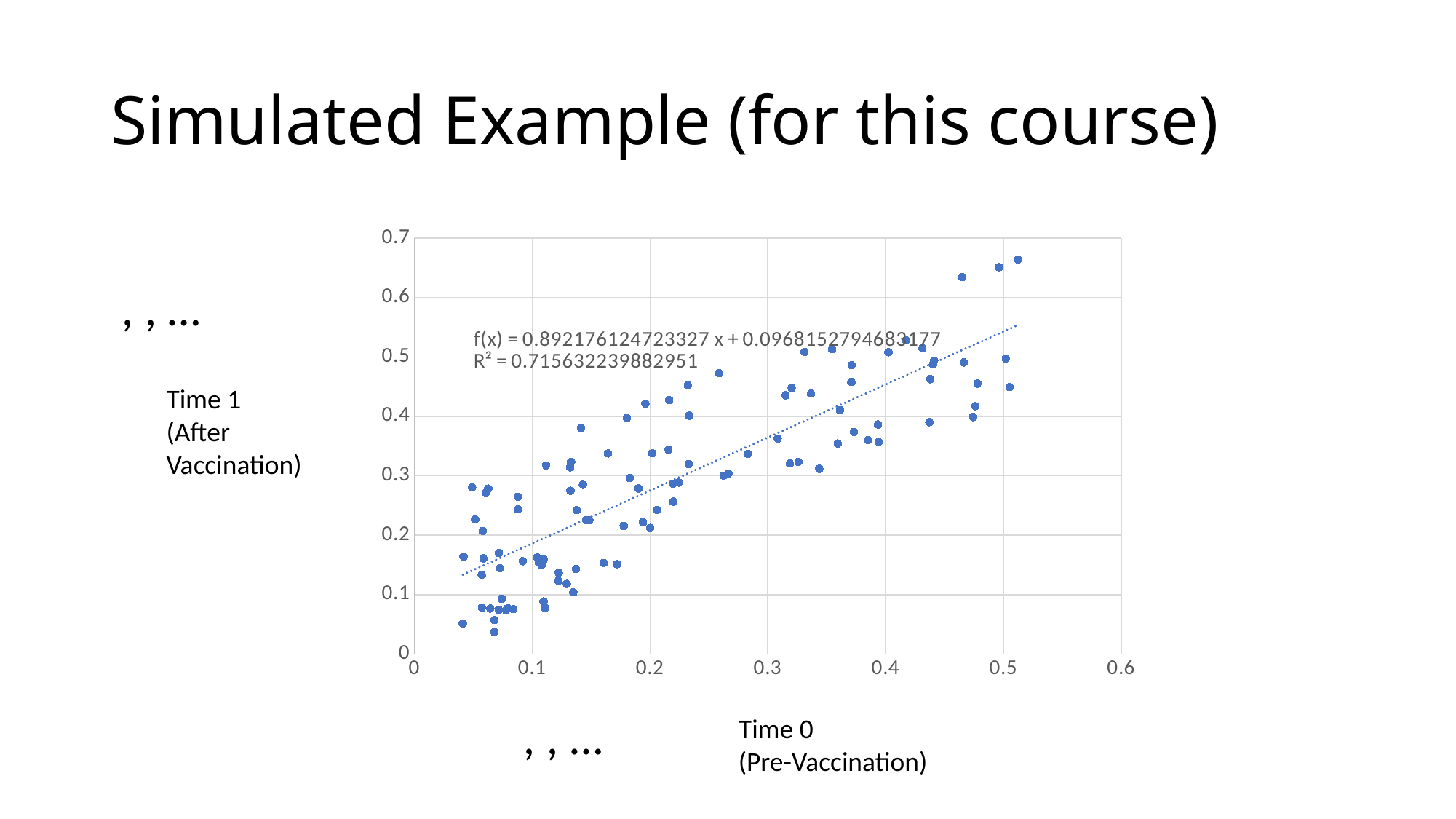
Is the largest plotted Time 0 (Pre-Vaccination) value greater or less than 0.5? greater What R² value is printed on the chart? 0.715632239882951 What kind of chart is shown on the slide? scatter plot Do the plotted values generally rise or fall as Time 0 (Pre-Vaccination) increases? rise Are there any plotted points with a Time 0 (Pre-Vaccination) value greater than 0.6? No What is the slope of the fitted trendline equation shown on the chart? 0.892176124723327 Is the lowest plotted Time 1 (After Vaccination) value greater or less than 0.1? less